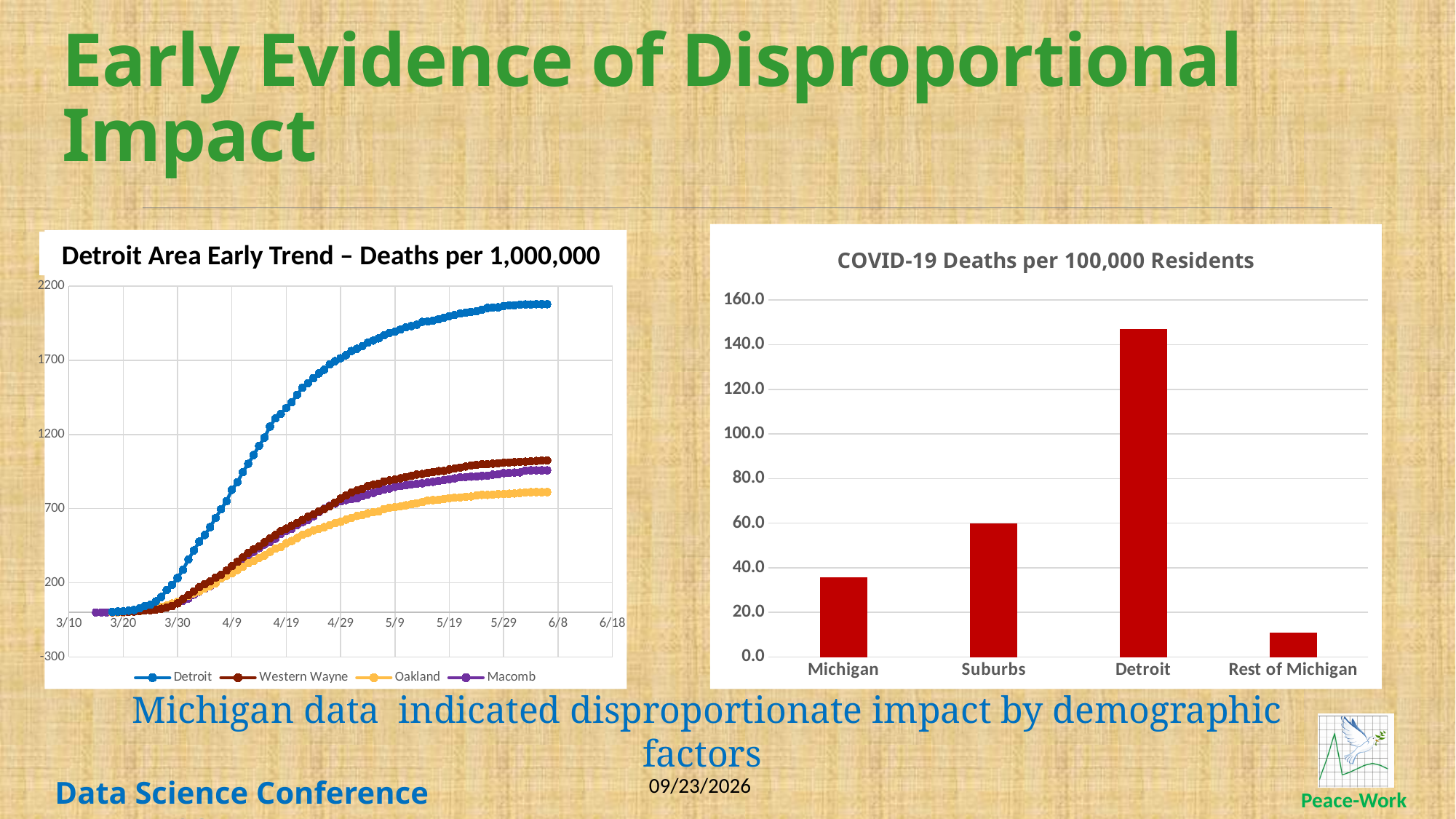
What kind of chart is the chart titled "COVID-19 Deaths per 100,000 Residents"? bar chart How many categories are shown in the chart titled "COVID-19 Deaths per 100,000 Residents"? 4 In the chart titled "Detroit Area Early Trend – Deaths per 1,000,000", which series reaches the highest value? Detroit In the chart titled "COVID-19 Deaths per 100,000 Residents", is the value for Detroit greater or less than 140.0? greater In the chart titled "COVID-19 Deaths per 100,000 Residents", which category has the highest value? Detroit How many series does the legend list in the chart titled "Detroit Area Early Trend – Deaths per 1,000,000"? 4 In the chart titled "COVID-19 Deaths per 100,000 Residents", which category has the lowest value? Rest of Michigan In the chart titled "Detroit Area Early Trend – Deaths per 1,000,000", do the values for Detroit rise or fall along the x axis? rise In the chart titled "Detroit Area Early Trend – Deaths per 1,000,000", is the final value for Detroit greater or less than 1700? greater In the chart titled "COVID-19 Deaths per 100,000 Residents", which is larger, the value for Suburbs or the value for Michigan? Suburbs In the chart titled "COVID-19 Deaths per 100,000 Residents", is the value for Michigan greater or less than 40.0? less